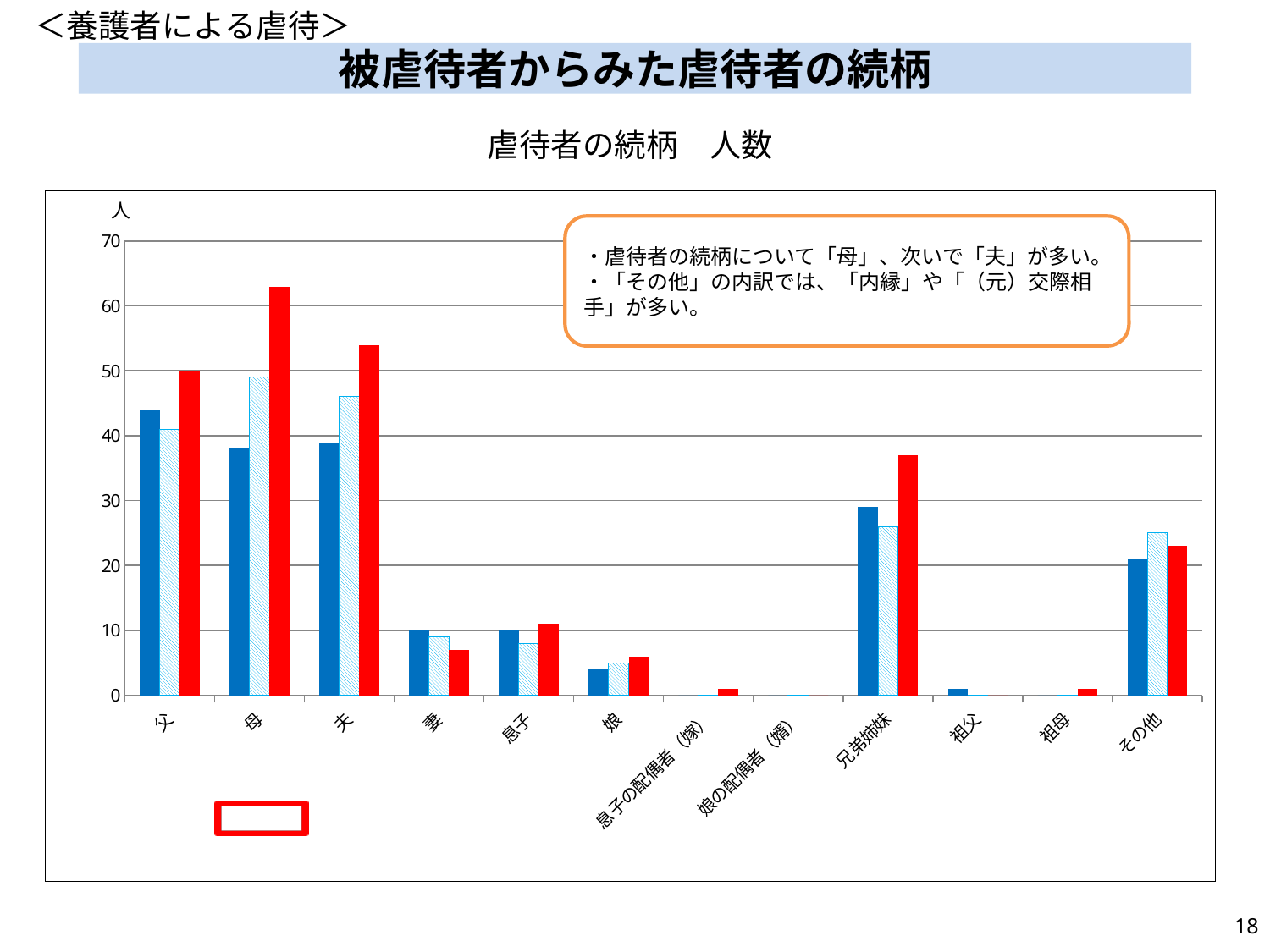
What is the title of the chart? 虐待者の続柄 人数 Is the red bar for 妻 greater or less than 10? less What kind of chart is shown on the slide? bar chart What unit label is shown at the top of the vertical axis? 人 Is the solid blue bar for 父 greater or less than 40? greater Which is larger, the red bar for 母 or the red bar for 夫? 母 Which category has the tallest red bar? 母 How many categories are shown on the x axis of the chart? 12 Is the red bar for 兄弟姉妹 greater or less than 30? greater Which category has the tallest bar in the chart? 母